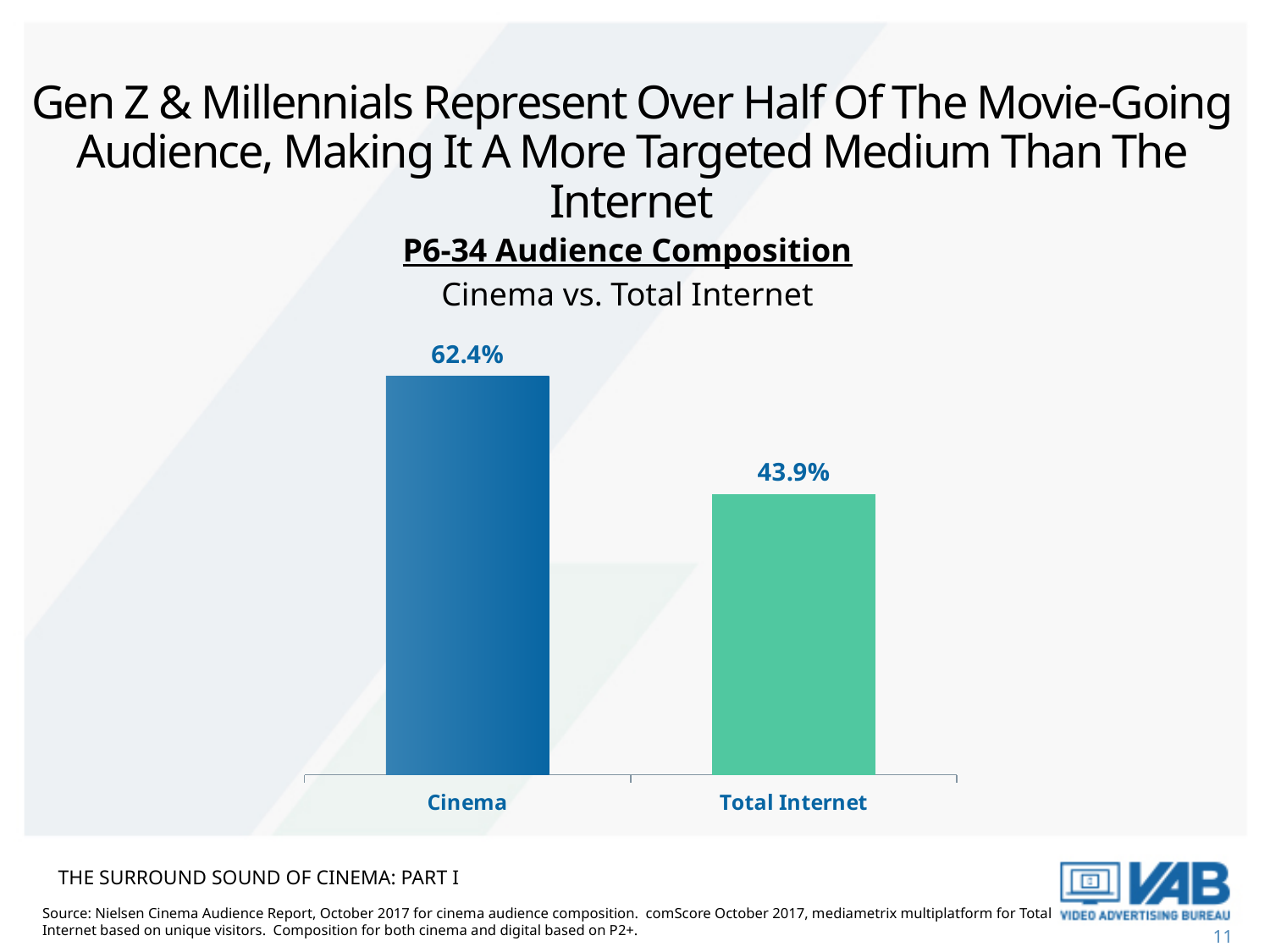
What is the P6-34 audience composition value for Total Internet? 43.9% Which category has the higher P6-34 audience composition? Cinema What is the difference in percentage points between the Cinema and Total Internet values? 18.5 What kind of chart is shown on the slide? bar chart What is the P6-34 audience composition value for Cinema? 62.4% Is the value for Cinema larger or smaller than the value for Total Internet? larger What is the subtitle shown below the chart title? Cinema vs. Total Internet How many categories are shown in the chart? 2 What is the underlined title of the chart? P6-34 Audience Composition Which category has the lower P6-34 audience composition? Total Internet